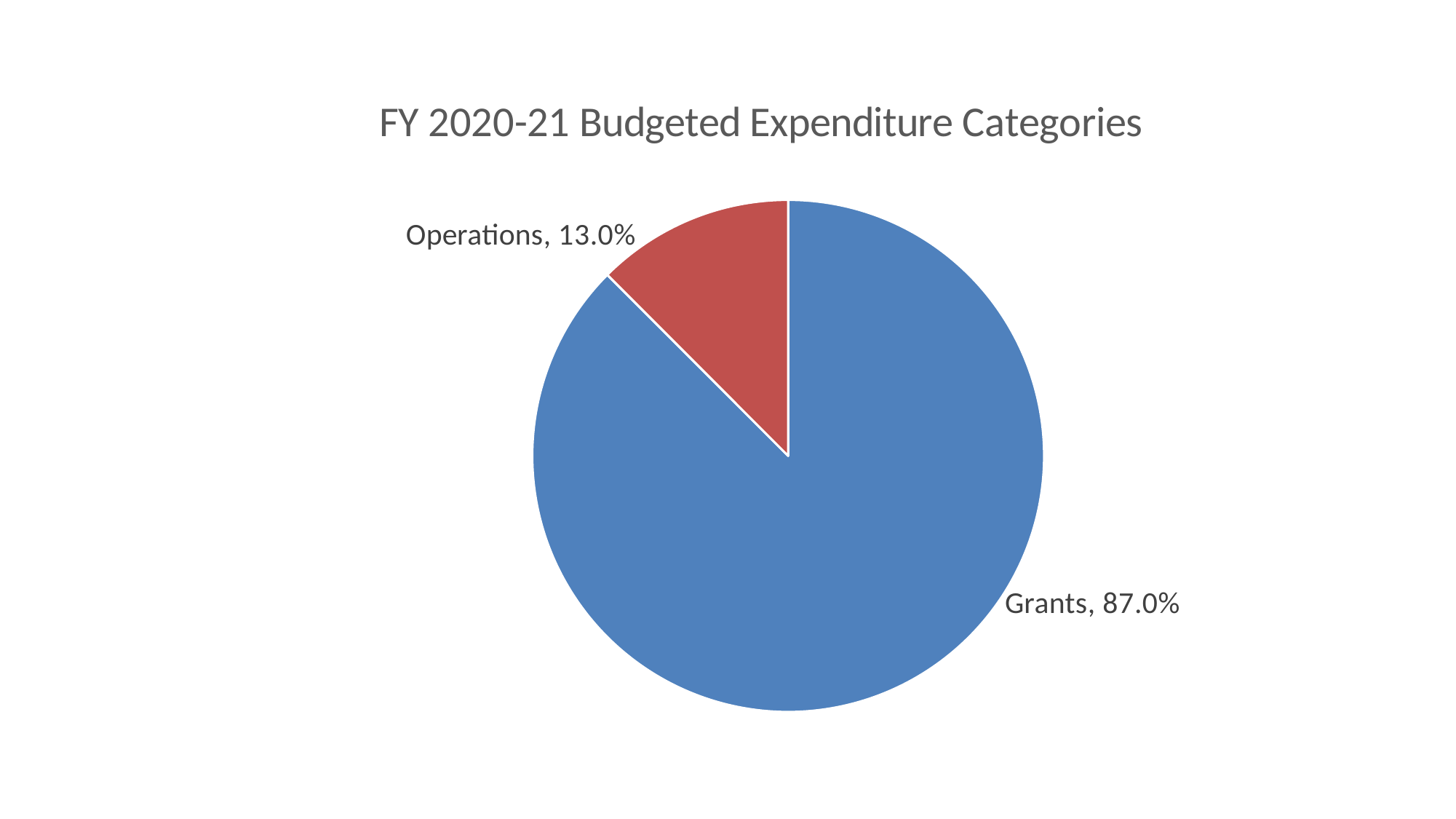
What share of the pie does Grants represent? 87.0% What colour is the Operations slice? red Which category has the largest slice of the pie? Grants Which is larger, the Grants slice or the Operations slice? Grants Which category has the smallest slice of the pie? Operations What is the combined share of Grants and Operations? 100.0% What is the difference in percentage points between Grants and Operations? 74.0 How many categories are shown in the pie chart? 2 What kind of chart is shown on the slide? pie chart What is the title of the chart? FY 2020-21 Budgeted Expenditure Categories What share of the pie does Operations represent? 13.0%